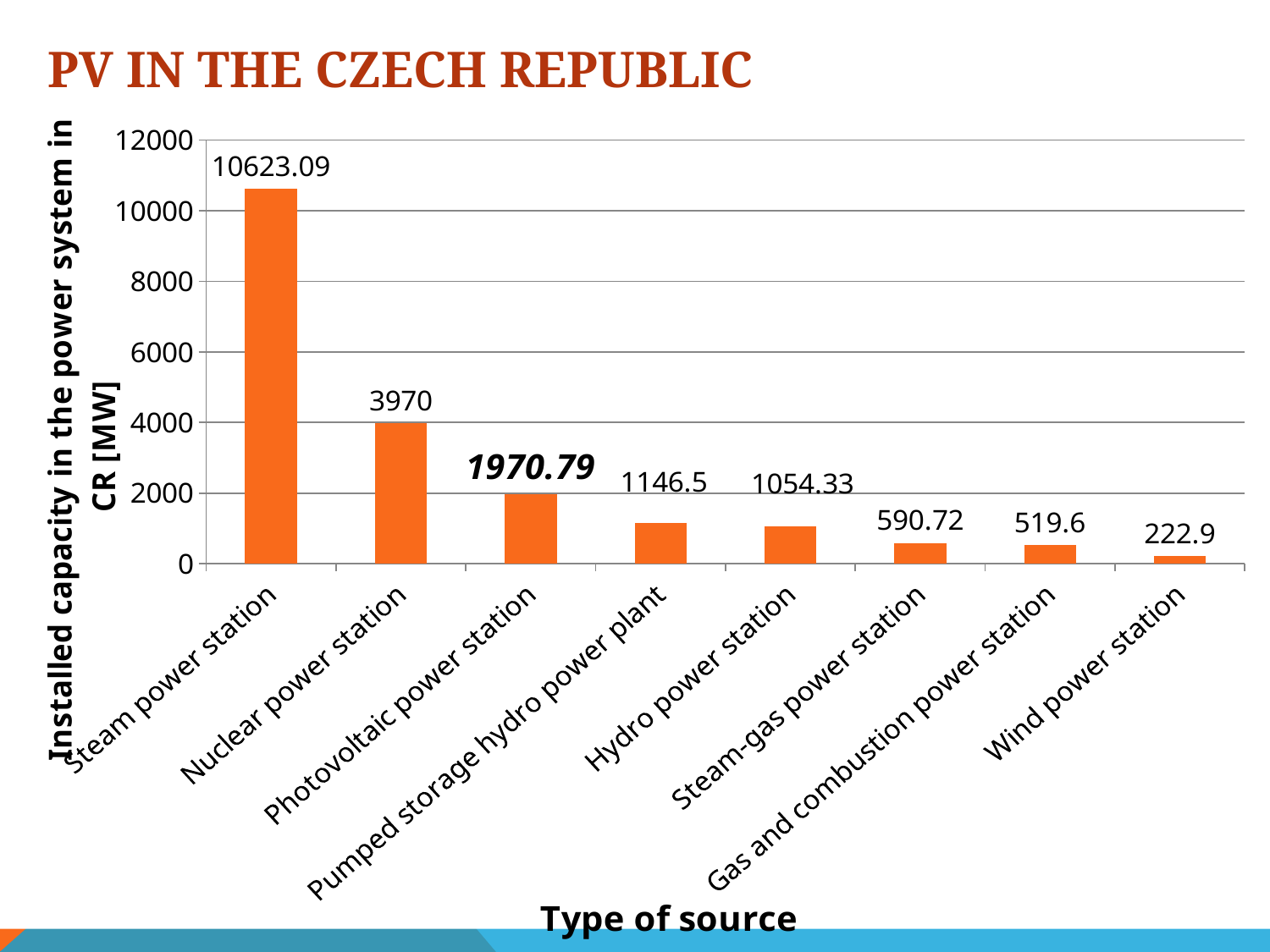
How many types of source are shown in the chart? 8 What is the label of the x axis? Type of source What kind of chart is shown on the slide? Bar chart What is the difference in installed capacity between Steam power station and Nuclear power station? 6653.09 Which type of source has the lowest installed capacity? Wind power station Which type of source has the highest installed capacity? Steam power station Which has a larger installed capacity, Pumped storage hydro power plant or Hydro power station? Pumped storage hydro power plant What is the installed capacity for Nuclear power station? 3970 Is the installed capacity for Gas and combustion power station greater or less than 1000? less What is the installed capacity for Photovoltaic power station? 1970.79 What is the installed capacity for Steam-gas power station? 590.72 What is the installed capacity for Wind power station? 222.9